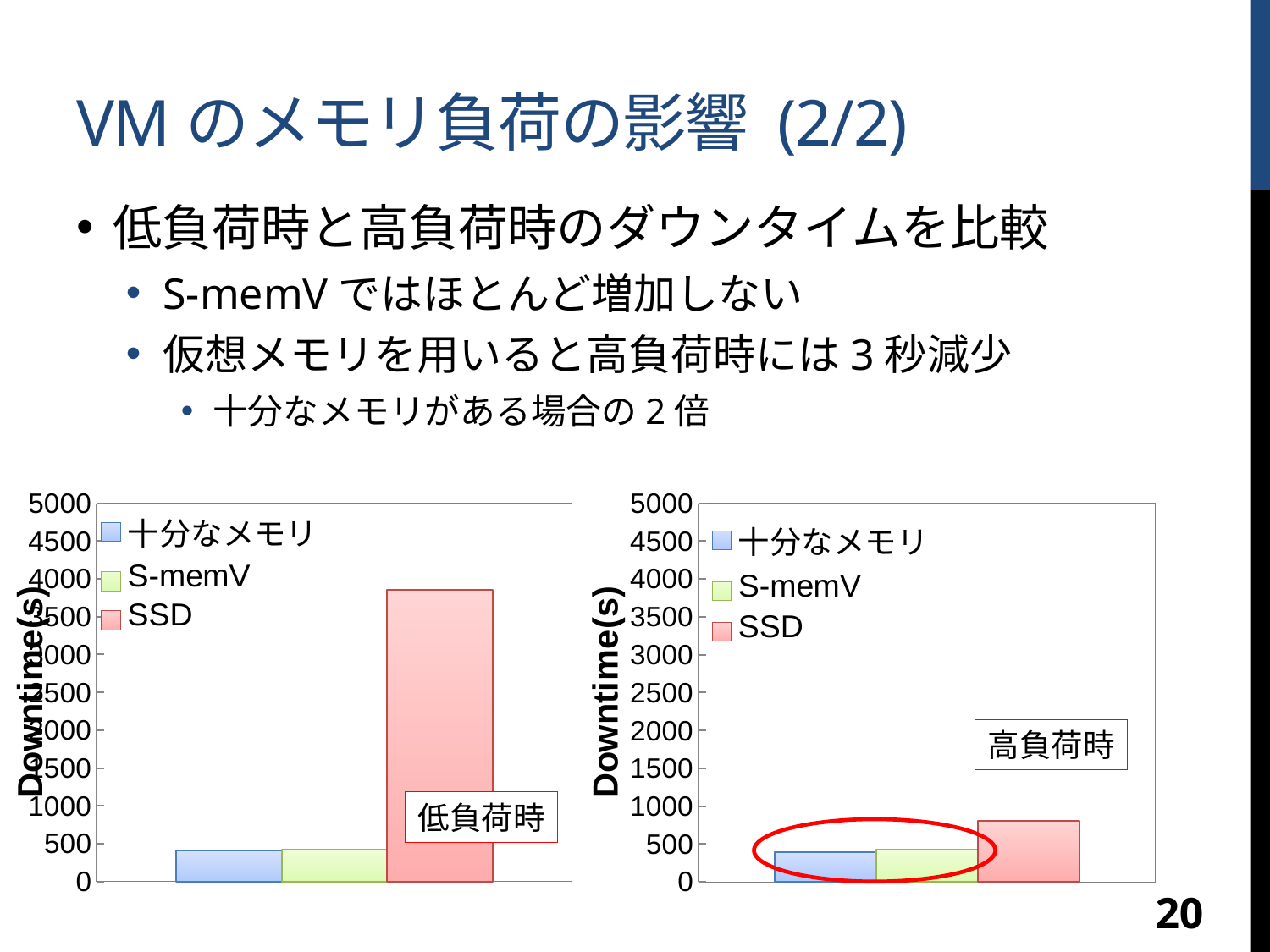
What is the y-axis label of the left chart (低負荷時)? Downtime(s) In the right chart (高負荷時), is the value for S-memV greater or less than 500? less In the left chart (低負荷時), is the value for SSD greater or less than 4000? less In the right chart (高負荷時), which series has the highest downtime? SSD Which is larger: the SSD value in the left chart (低負荷時) or the SSD value in the right chart (高負荷時)? left chart (低負荷時) What kind of chart is the left chart (低負荷時)? bar chart In the left chart (低負荷時), is the value for 十分なメモリ greater or less than 500? less How many series does the legend of the right chart (高負荷時) list? 3 In the left chart (低負荷時), which series has the highest downtime? SSD